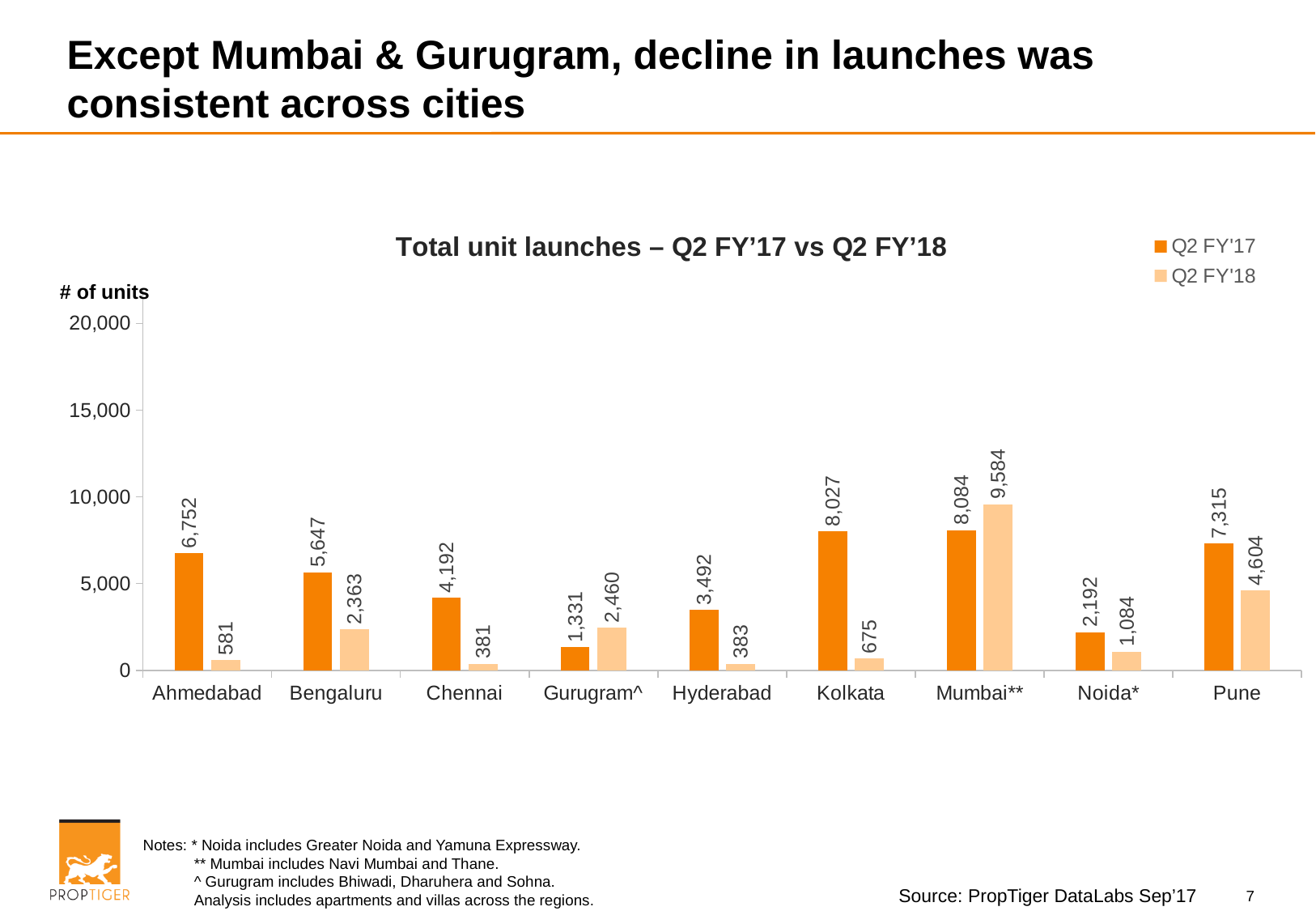
What was the number of unit launches in Ahmedabad in Q2 FY'17? 6,752 What was the number of unit launches in Gurugram^ in Q2 FY'18? 2,460 What kind of chart is shown on the slide? Bar chart What is the difference between Q2 FY'17 and Q2 FY'18 unit launches in Pune? 2,711 Which city had the highest number of unit launches in Q2 FY'18? Mumbai** What was the number of unit launches in Mumbai** in Q2 FY'18? 9,584 Which city had the lowest number of unit launches in Q2 FY'18? Chennai Which was larger for Kolkata: unit launches in Q2 FY'17 or Q2 FY'18? Q2 FY'17 How many series does the legend list? 2 Which city had the lowest number of unit launches in Q2 FY'17? Gurugram^ How many cities are shown on the x axis of the chart? 9 Is the Q2 FY'17 value for Mumbai** greater or less than 10,000? less